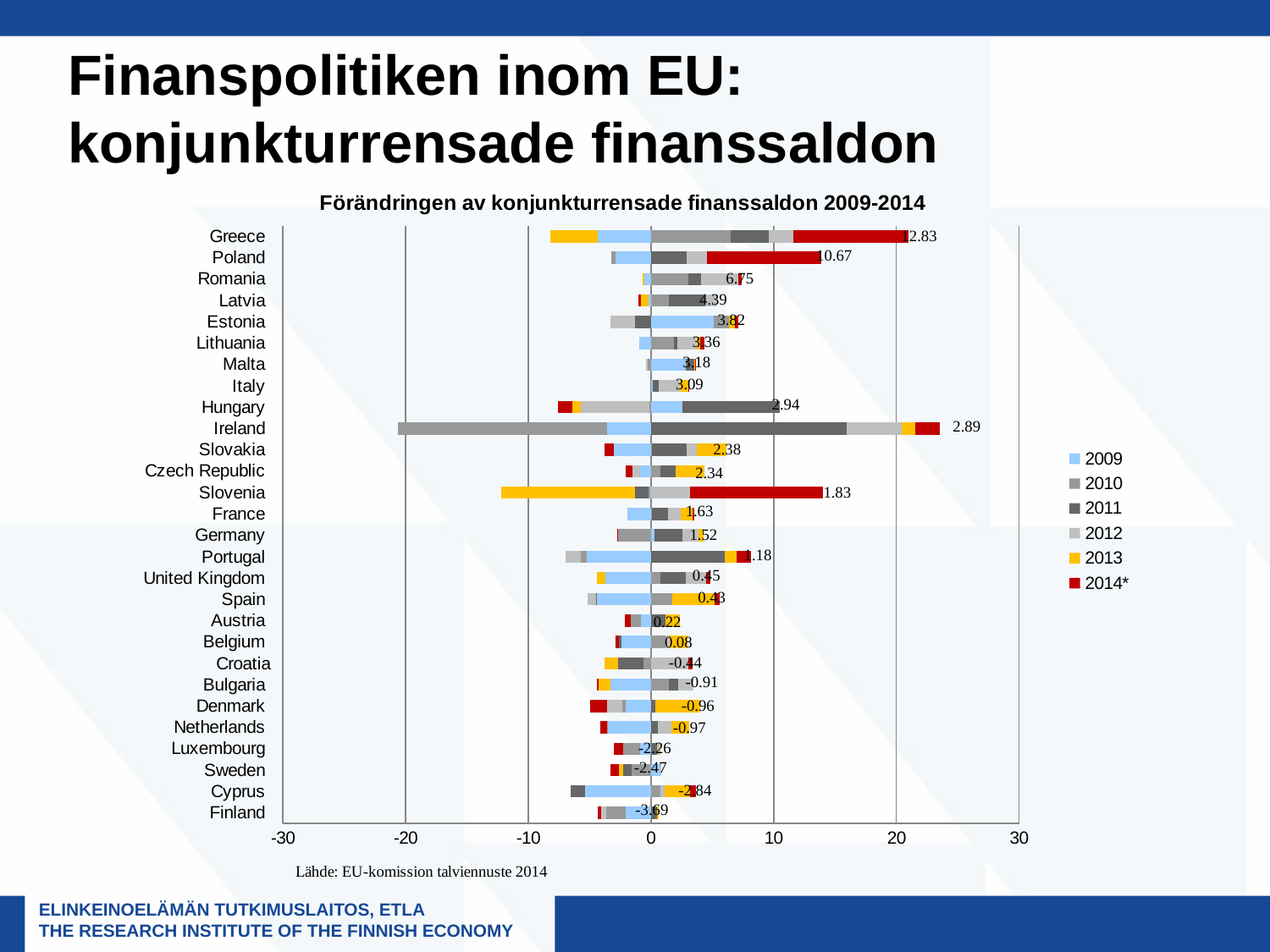
What is the title of the chart? Förändringen av konjunkturrensade finanssaldon 2009-2014 What kind of chart is shown on the slide? bar chart What is the difference between the labelled values for Poland and Romania? 3.92 What is the value labelled for Poland? 10.67 How many countries are shown on the chart? 28 What is the value labelled for Ireland? 2.89 Which country has the lowest labelled value? Finland Which legend entry is marked with an asterisk? 2014* Which has the larger labelled value, Sweden or Cyprus? Sweden How many series does the legend list? 6 What is the value labelled for Slovenia? 1.83 What is the value labelled for Finland? -3.69